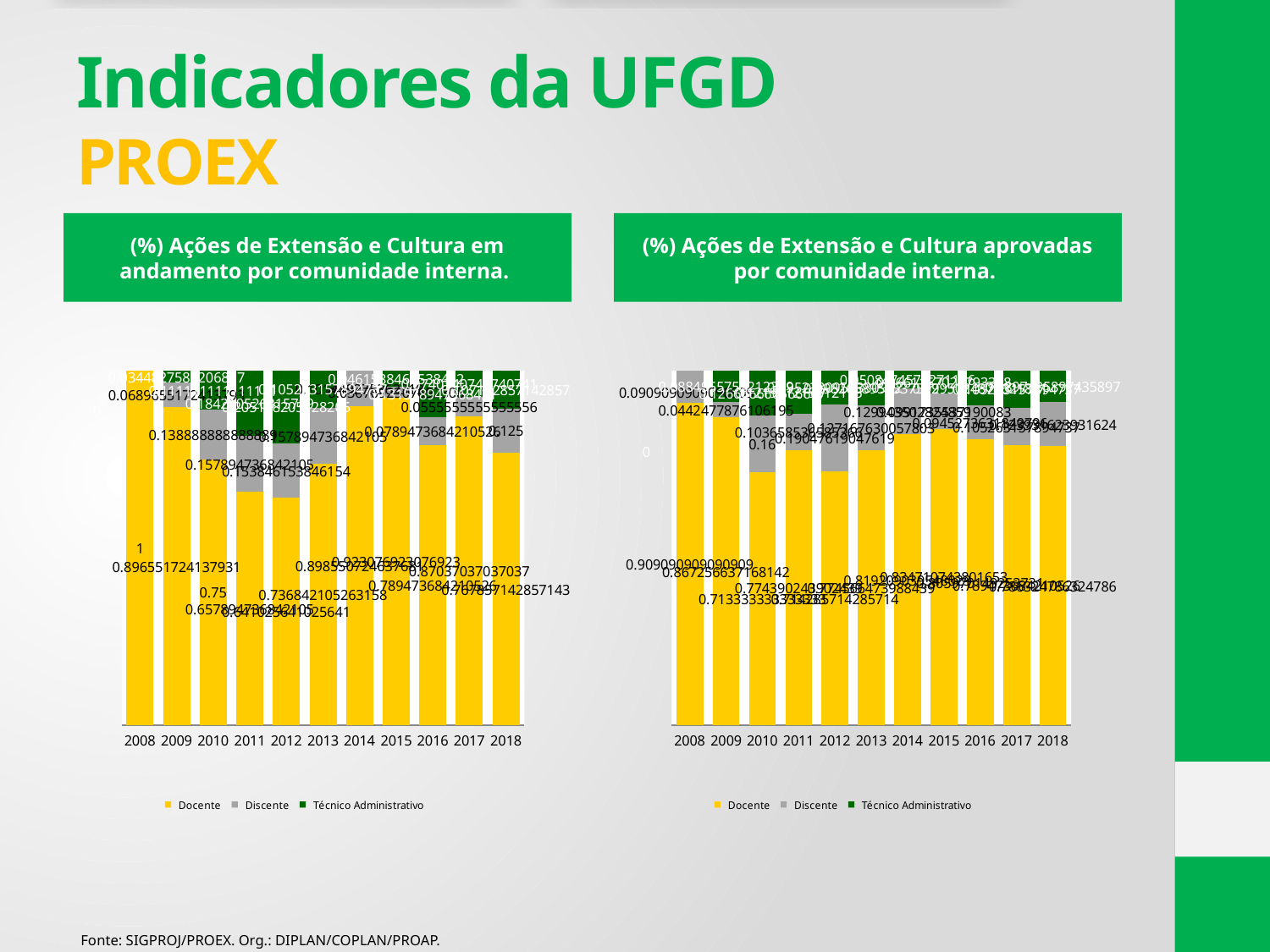
How many years are shown on the x axis of the right chart, '(%) Ações de Extensão e Cultura aprovadas por comunidade interna'? 11 What is the first year shown on the x axis of the left chart? 2008 In the right chart, which year has the highest Docente value? 2008 In the right chart, what is the Docente value for 2009? 0.867256637168142 In the left chart, what is the Docente value for 2009? 0.896551724137931 How many series does the legend of the left chart list? 3 In the right chart, what is the Docente value for 2008? 0.909090909090909 What kind of chart is the left chart, '(%) Ações de Extensão e Cultura em andamento por comunidade interna'? Stacked bar chart In the right chart, what is the Discente value for 2008? 0.0909090909090909 What are the legend entries of the right chart? Docente, Discente, Técnico Administrativo In the right chart, is the Docente value for 2008 larger or smaller than the Docente value for 2009? Larger In the left chart, what is the Discente value for 2016? 0.0789473684210526